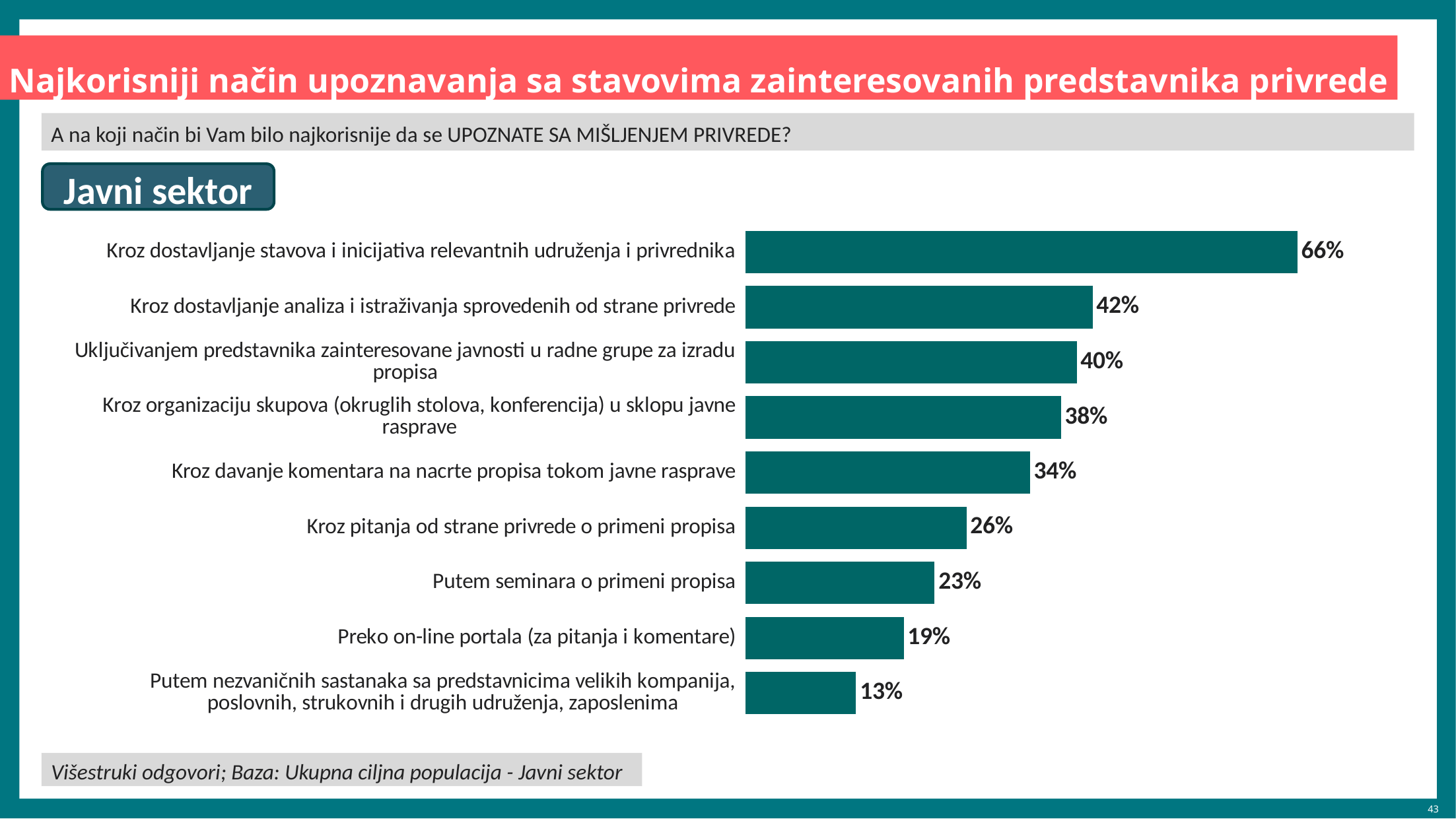
What is the difference between the values for "Kroz dostavljanje analiza i istraživanja sprovedenih od strane privrede" and "Kroz davanje komentara na nacrte propisa tokom javne rasprave"? 8% What value is shown for "Kroz dostavljanje stavova i inicijativa relevantnih udruženja i privrednika"? 66% Which category has the lowest value? Putem nezvaničnih sastanaka sa predstavnicima velikih kompanija, poslovnih, strukovnih i drugih udruženja, zaposlenima How many categories are shown in the chart? 9 Which sector label is shown above the chart? Javni sektor What value is shown for "Kroz organizaciju skupova (okruglih stolova, konferencija) u sklopu javne rasprave"? 38% What kind of chart is shown on the slide? Bar chart What is the difference between the highest and lowest values in the chart? 53% What value is shown for "Putem seminara o primeni propisa"? 23% Which is larger: the value for "Kroz pitanja od strane privrede o primeni propisa" or the value for "Putem seminara o primeni propisa"? Kroz pitanja od strane privrede o primeni propisa What value is shown for "Preko on-line portala (za pitanja i komentare)"? 19% Which category has the highest value? Kroz dostavljanje stavova i inicijativa relevantnih udruženja i privrednika